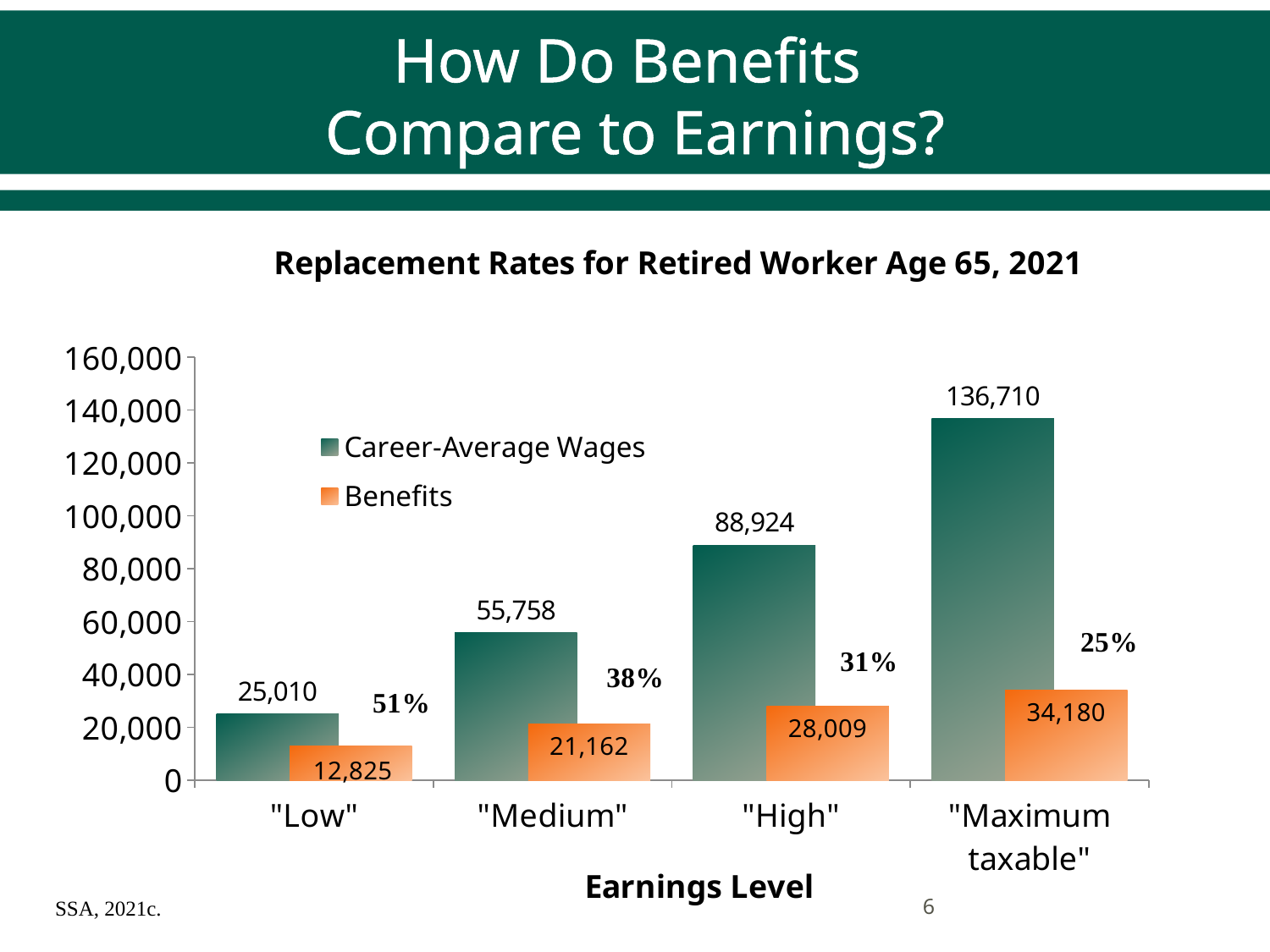
Which is larger: Benefits for "High" or Benefits for "Medium"? Benefits for "High" Which earnings level has the lowest Career-Average Wages value? "Low" What is the title of the chart? Replacement Rates for Retired Worker Age 65, 2021 What is the difference between Career-Average Wages and Benefits for the "Low" earnings level? 12,185 Which earnings level has the highest Benefits value? "Maximum taxable" What kind of chart is shown on the slide? bar chart Is the Career-Average Wages value for "Medium" greater or less than 40,000? greater What is the Benefits value for the "Medium" earnings level? 21,162 What is the Career-Average Wages value for the "Maximum taxable" earnings level? 136,710 What is the Career-Average Wages value for the "High" earnings level? 88,924 How many series does the legend list? 2 How many earnings levels are shown on the x axis? 4